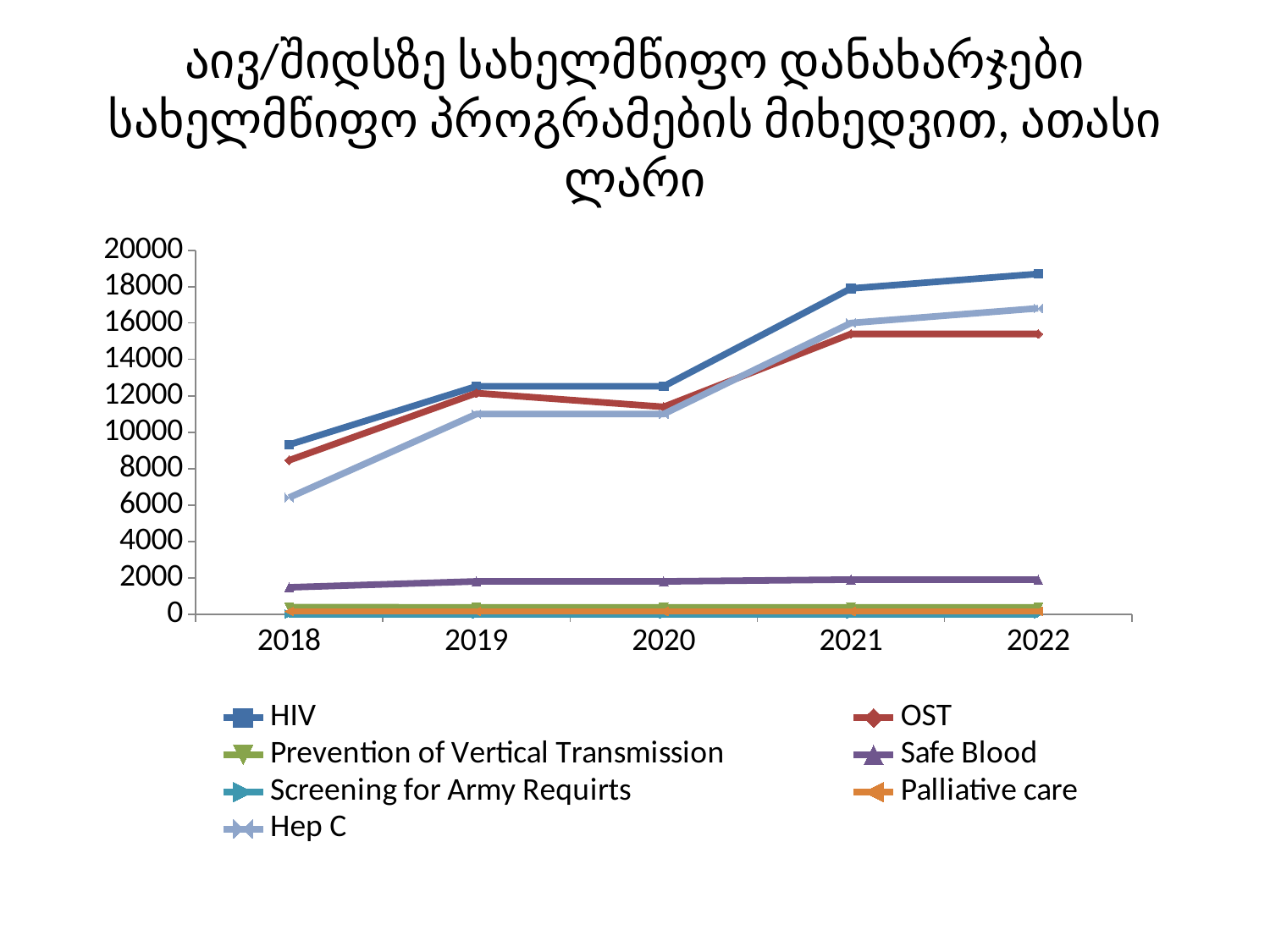
Is the value for Hep C in 2018 greater or less than 6000? greater Which series is drawn in red? OST How many series does the legend list? 7 Is the value for HIV in 2018 greater or less than 10000? less Does the HIV line rise or fall from 2018 to 2022? rise Which series has the highest value in 2022? HIV What kind of chart is shown on the slide? line chart How many years are shown on the x axis? 5 Is the value for OST in 2021 greater or less than 14000? greater In 2022, which is larger: Hep C or OST? Hep C